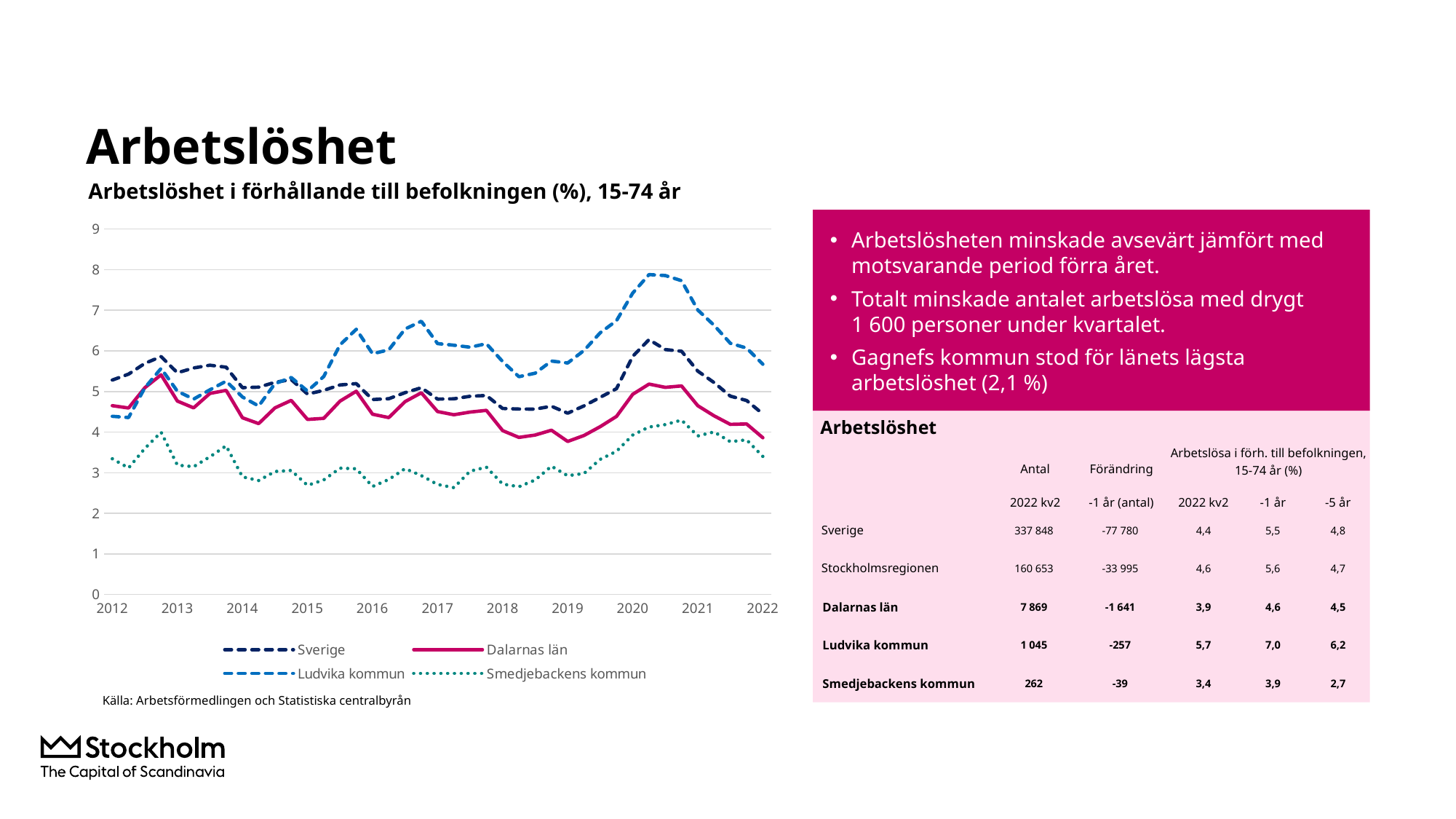
What is the title of the chart? Arbetslöshet i förhållande till befolkningen (%), 15-74 år In 2020, which series is higher: Ludvika kommun or Smedjebackens kommun? Ludvika kommun Which series has the lowest values across the chart? Smedjebackens kommun What is the highest value shown on the chart's y axis? 9 Is the value for Smedjebackens kommun at the start of the chart in 2012 greater or less than 3? greater Is the value for Dalarnas län at the end of the chart in 2022 greater or less than 4? less Do the values for Ludvika kommun rise or fall from 2020 to 2022? fall Is the value for Sverige at the end of the chart in 2022 greater or less than 4? greater How many series does the chart legend list? 4 Which series has the highest values across the chart? Ludvika kommun What kind of chart is shown on the slide? line chart